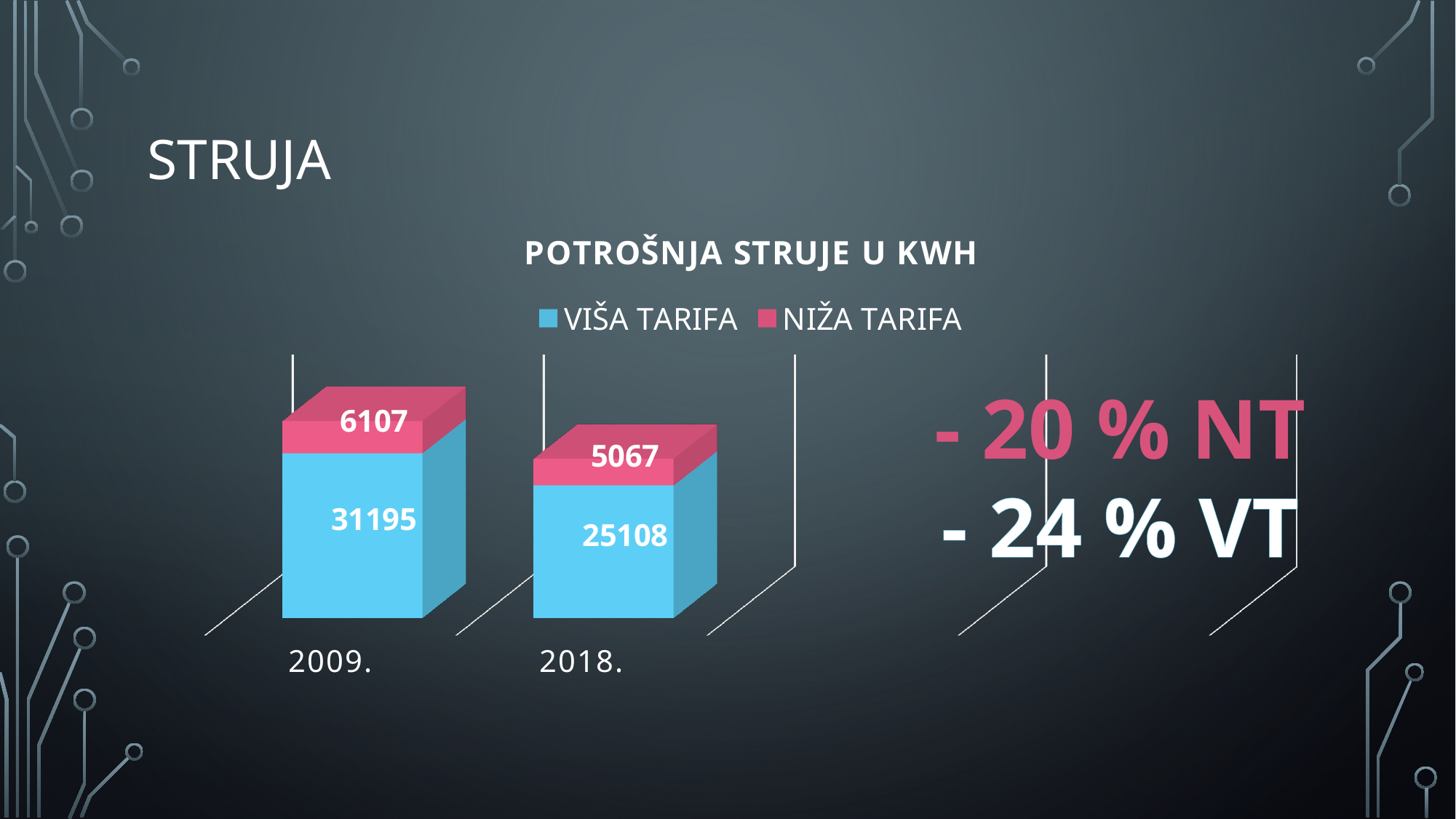
What is the value for NIŽA TARIFA in 2018.? 5067 How many series does the legend list? 2 What is the title of the chart? POTROŠNJA STRUJE U KWH How many categories are shown on the x axis? 2 What is the value for VIŠA TARIFA in 2018.? 25108 What is the value for VIŠA TARIFA in 2009.? 31195 What is the difference between the VIŠA TARIFA values for 2009. and 2018.? 6087 What is the total of the stacked bar for 2009.? 37302 What is the total of the stacked bar for 2018.? 30175 What is the value for NIŽA TARIFA in 2009.? 6107 What is the difference between the NIŽA TARIFA values for 2009. and 2018.? 1040 Which year has the higher VIŠA TARIFA value, 2009. or 2018.? 2009.